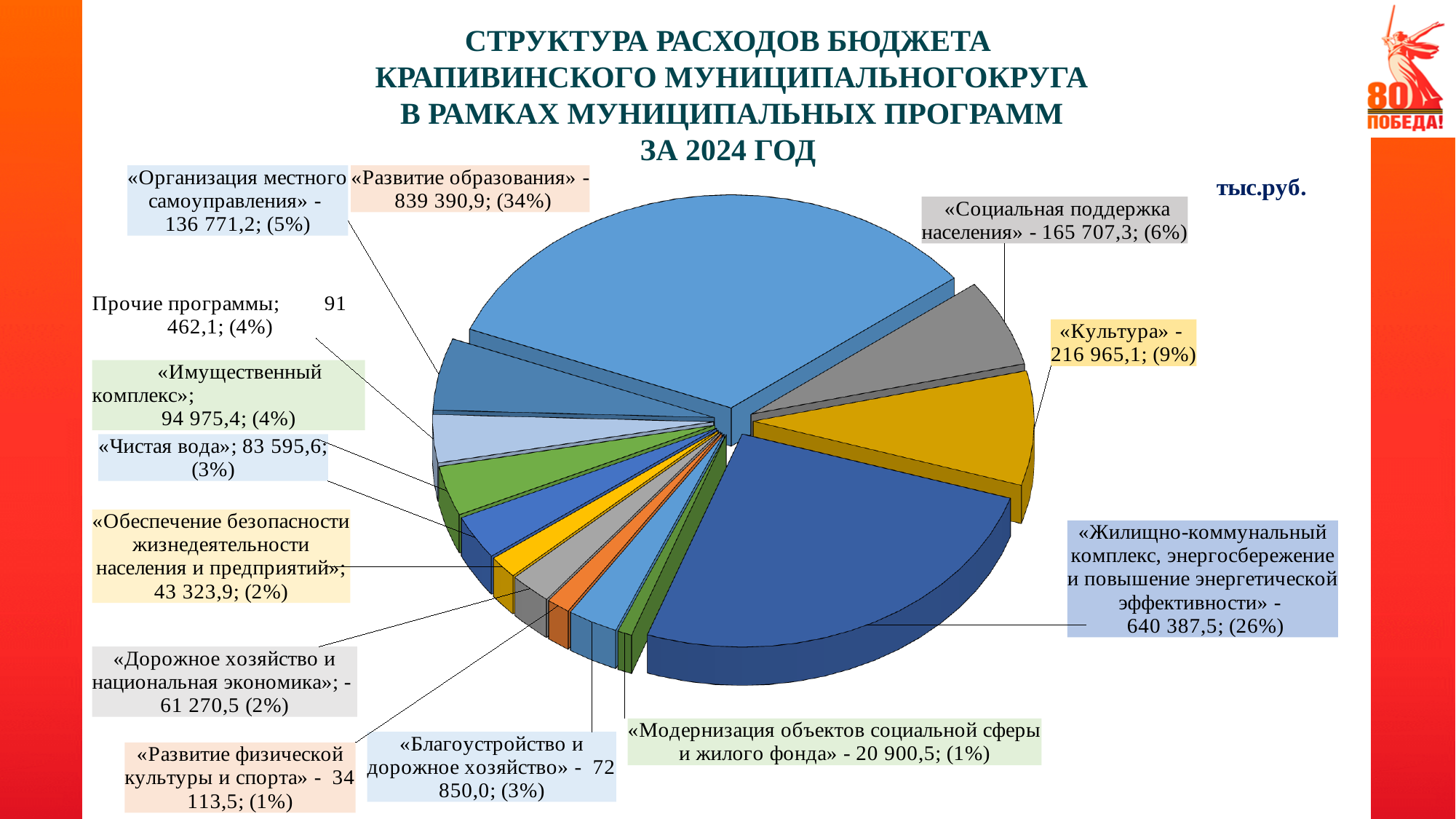
What is the value for «Развитие образования»? 839 390,9 How many categories (slices) does the pie chart show? 13 What is the value for «Культура»? 216 965,1 What kind of chart is shown on the slide? Pie chart What is the difference between the values for «Развитие образования» and «Жилищно-коммунальный комплекс, энергосбережение и повышение энергетической эффективности»? 199 003,4 What is the value for «Чистая вода»? 83 595,6 What share of the pie does «Социальная поддержка населения» represent? 6% What share of the pie does «Жилищно-коммунальный комплекс, энергосбережение и повышение энергетической эффективности» represent? 26% Which is larger: the value for «Имущественный комплекс» or the value for «Чистая вода»? «Имущественный комплекс» Which category has the smallest value? «Модернизация объектов социальной сферы и жилого фонда» In what units are the values on the chart given? тыс.руб. Which category has the largest share of the pie? «Развитие образования»